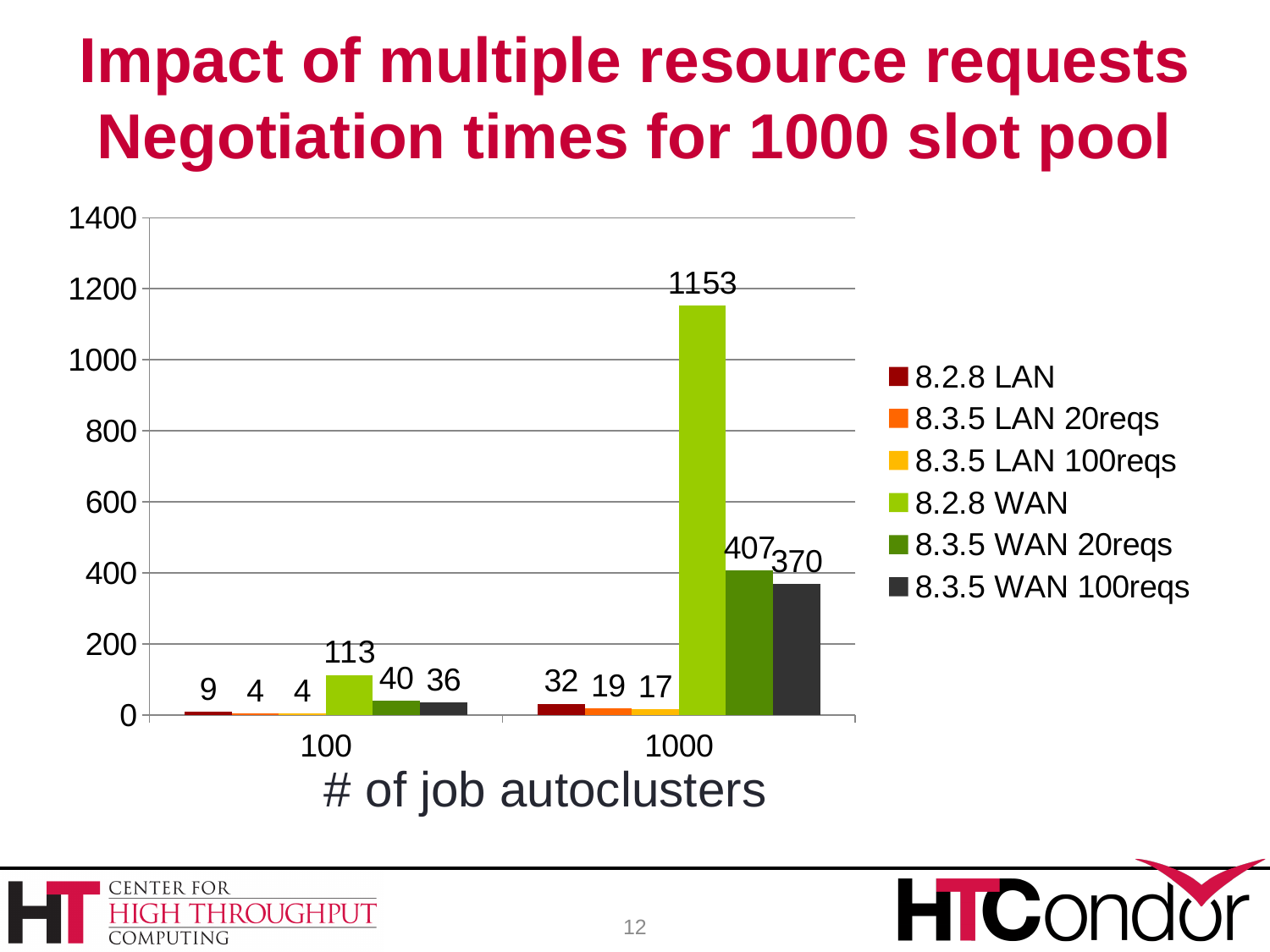
What is the value for 8.3.5 LAN 20reqs at 1000 job autoclusters? 19 What is the x-axis label of the chart? # of job autoclusters Is the value for 8.3.5 WAN 20reqs at 1000 job autoclusters greater or less than 600? less Which is larger at 100 job autoclusters: 8.2.8 WAN or 8.3.5 WAN 20reqs? 8.2.8 WAN What is the difference between the 8.2.8 WAN and 8.3.5 WAN 20reqs values at 1000 job autoclusters? 746 How many series does the legend list? 6 What kind of chart is shown on the slide? bar chart What is the value for 8.3.5 WAN 100reqs at 1000 job autoclusters? 370 Which series has the highest value at 1000 job autoclusters? 8.2.8 WAN What is the value for 8.2.8 WAN at 1000 job autoclusters? 1153 Which series has the lowest value at 1000 job autoclusters? 8.3.5 LAN 100reqs What is the value for 8.2.8 LAN at 100 job autoclusters? 9